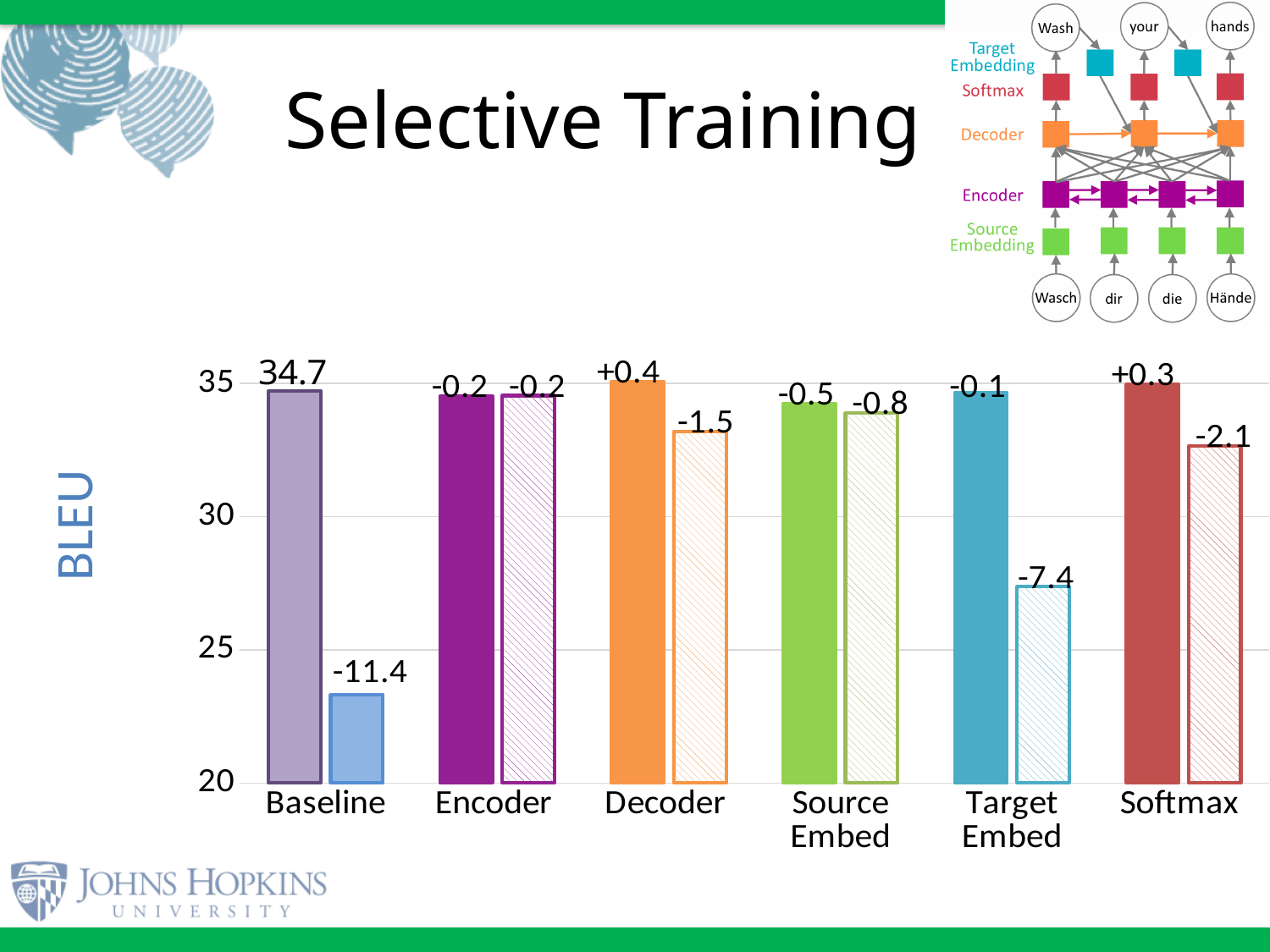
What is the label on the y axis of the chart? BLEU What label is printed above the hatched bar for Softmax? -2.1 Is the hatched Target Embed bar greater or less than 30 BLEU? less Which category has the lowest bar in the chart? Baseline What label is printed above the hatched bar for Source Embed? -0.8 What value is printed above the solid Baseline bar? 34.7 What kind of chart is shown on the slide? bar chart What label is printed above the hatched bar for Target Embed? -7.4 How many categories are shown along the x axis of the chart? 6 What label is printed above the solid bar for Decoder? +0.4